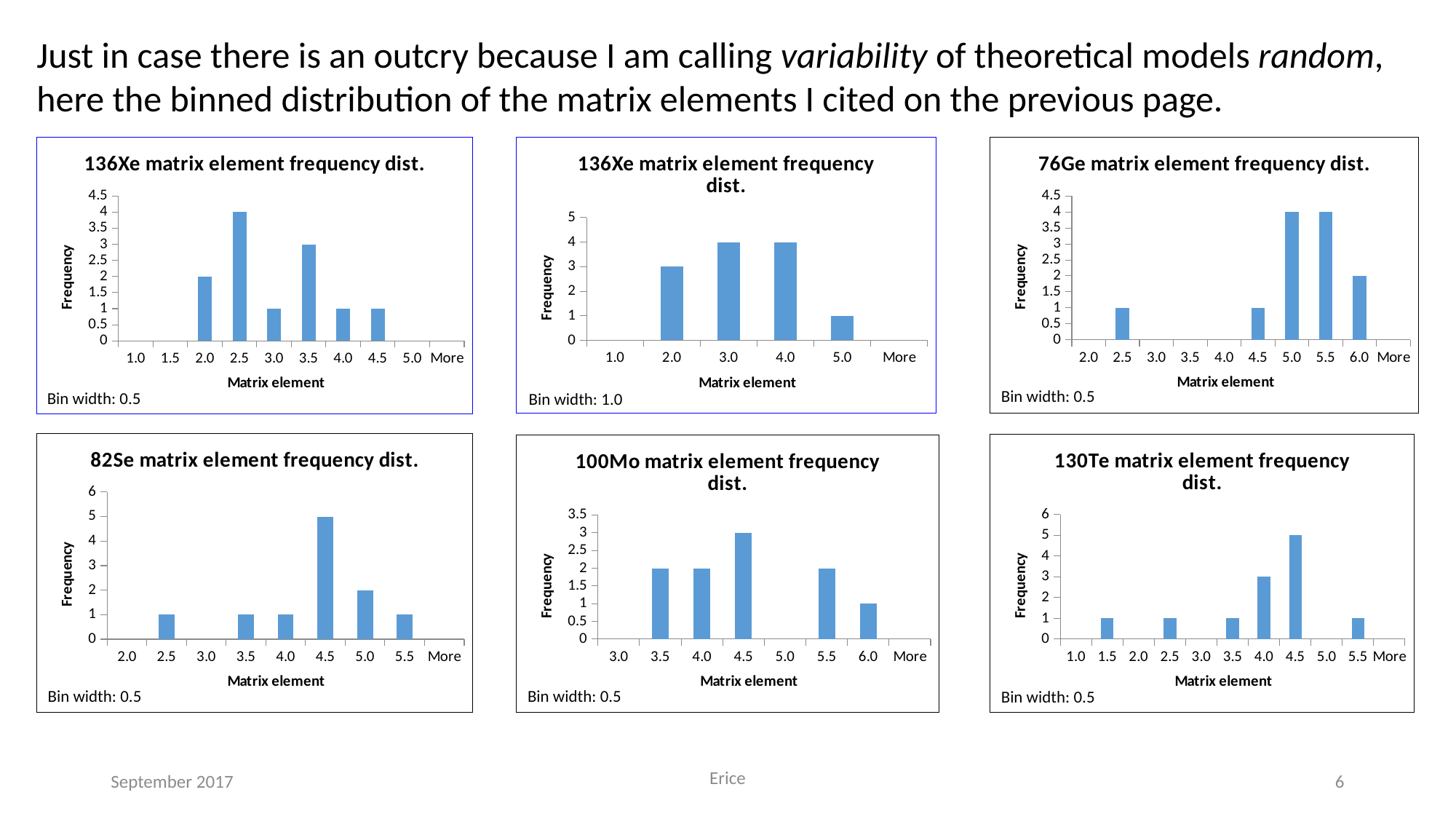
In the bottom-right chart titled '130Te matrix element frequency dist.', what is the difference between the frequency of the 4.5 bin and the 4.0 bin? 2 In the top-right chart titled '76Ge matrix element frequency dist.', which is larger, the frequency for the 5.0 bin or the 6.0 bin? 5.0 In the top-left chart titled '136Xe matrix element frequency dist.' (bin width 0.5), which matrix element bin has the highest frequency? 2.5 In the top-middle chart titled '136Xe matrix element frequency dist.' (bin width 1.0), what is the difference between the frequency of the 3.0 bin and the 5.0 bin? 3 In the top-right chart titled '76Ge matrix element frequency dist.', what is the frequency for the 6.0 bin? 2 In the bottom-left chart titled '82Se matrix element frequency dist.', which matrix element bin has the highest frequency? 4.5 In the bottom-left chart titled '82Se matrix element frequency dist.', what is the frequency for the 5.0 bin? 2 In the top-middle chart titled '136Xe matrix element frequency dist.' (bin width 1.0), what is the frequency for the 2.0 bin? 3 How many bins are labelled on the x axis of the bottom-right chart titled '130Te matrix element frequency dist.'? 11 In the top-left chart titled '136Xe matrix element frequency dist.' (bin width 0.5), what is the frequency for the 2.5 bin? 4 In the bottom-middle chart titled '100Mo matrix element frequency dist.', what is the frequency for the 4.5 bin? 3 What kind of chart is the top-right chart titled '76Ge matrix element frequency dist.'? Bar chart